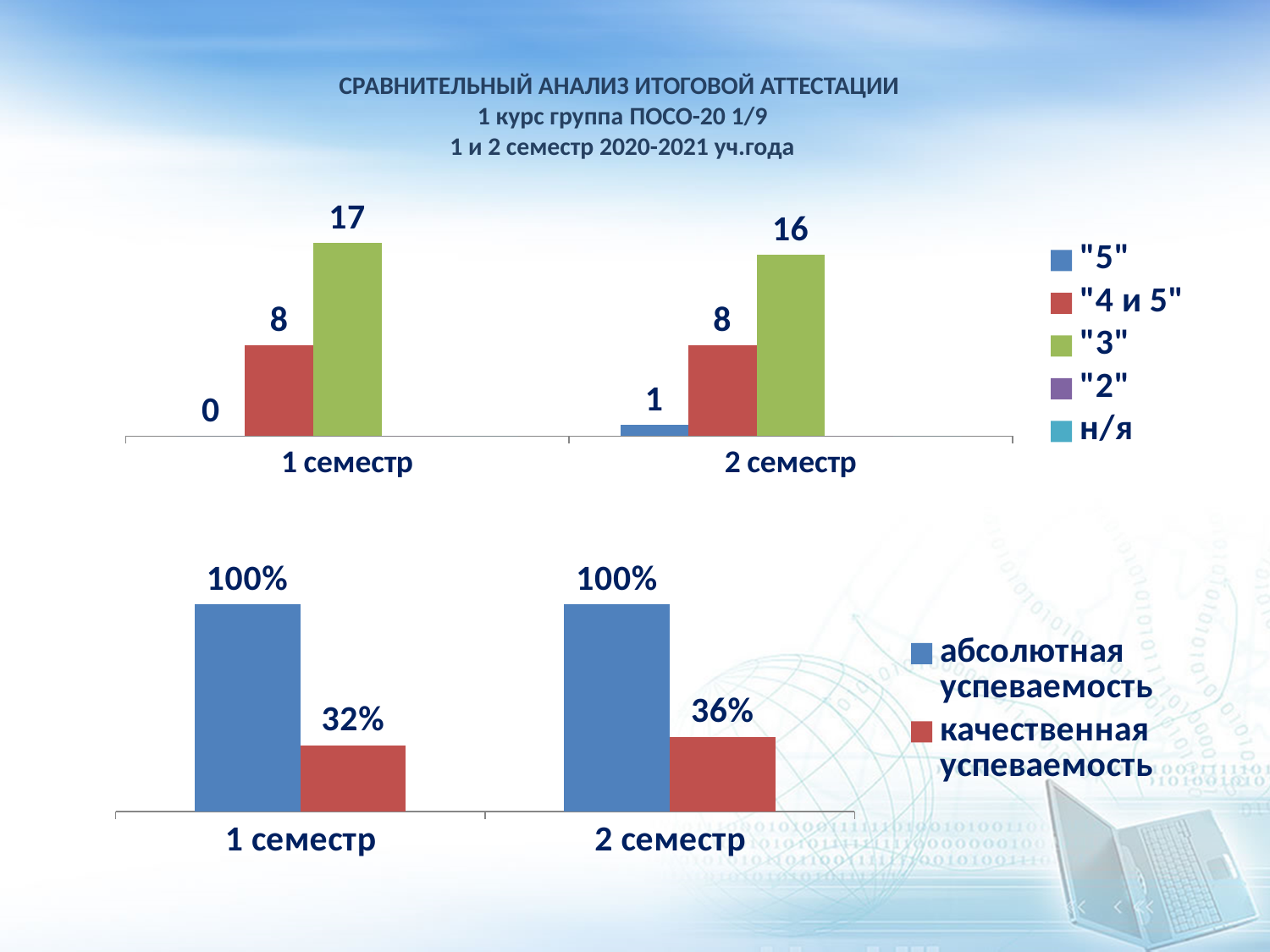
In the top chart, what is the value for "3" in 1 семестр? 17 In the top chart, what is the difference between the "3" values for 1 семестр and 2 семестр? 1 What kind of chart is the bottom chart? bar chart In the top chart, how many series does the legend list? 5 In the bottom chart, what is the value for качественная успеваемость in 2 семестр? 36% In the top chart, what is the value for "5" in 1 семестр? 0 In the top chart, what is the value for "4 и 5" in 2 семестр? 8 In the top chart, which series has the highest value in 2 семестр? "3" In the bottom chart, what is the value for абсолютная успеваемость in 1 семестр? 100% In the bottom chart, which is larger: качественная успеваемость in 1 семестр or in 2 семестр? 2 семестр In the bottom chart, what is the difference between абсолютная успеваемость and качественная успеваемость in 1 семестр? 68% In the top chart, what is the value for "5" in 2 семестр? 1